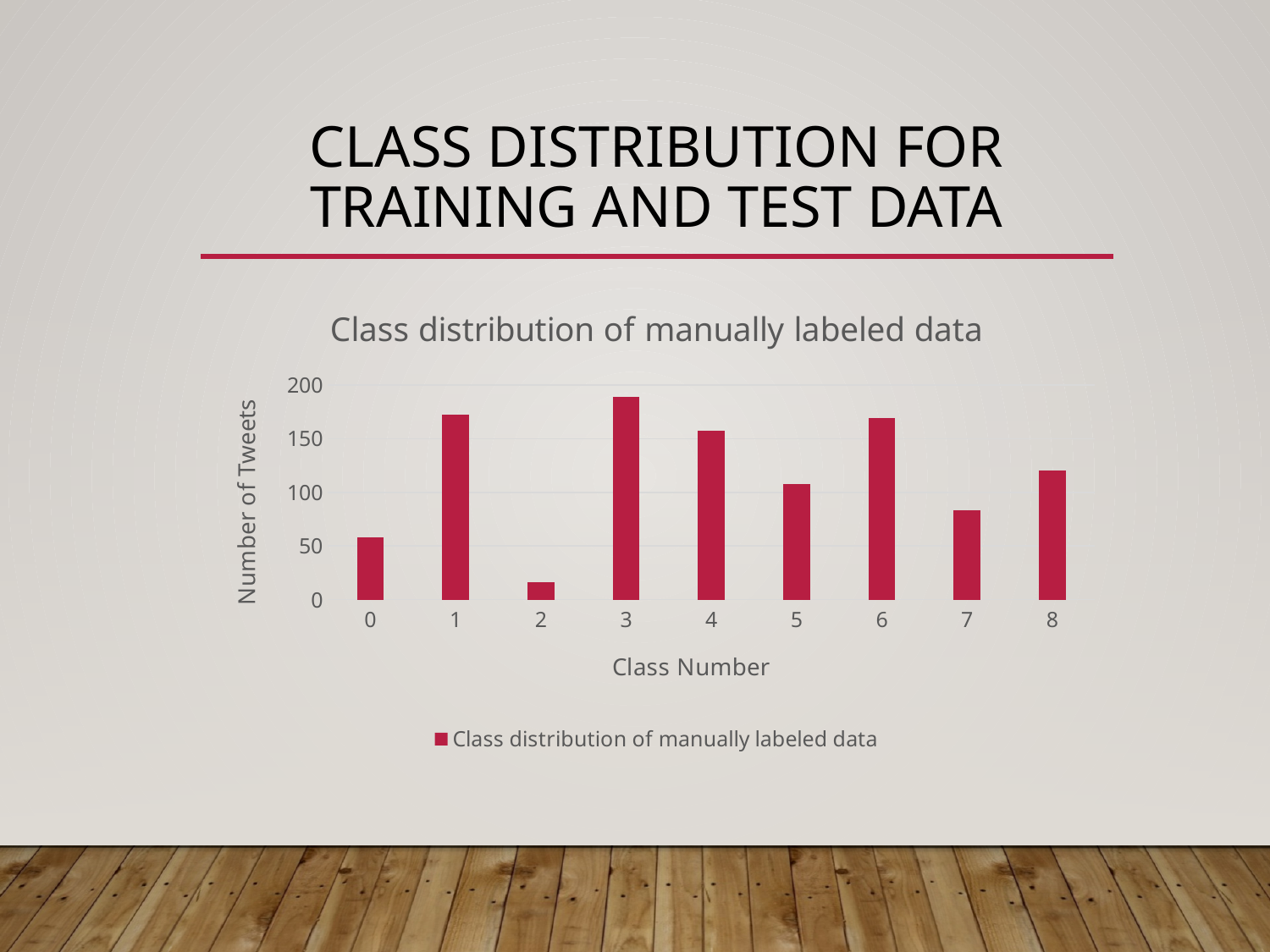
What kind of chart is shown on the slide? bar chart Which has more tweets, class 4 or class 8? class 4 How many series does the legend list? 1 How many class numbers are shown on the x axis of the chart? 9 Is the number of tweets for class 2 greater or less than 50? less What is the title of the chart? Class distribution of manually labeled data Which class number has the highest number of tweets? 3 Which has more tweets, class 0 or class 5? class 5 Is the number of tweets for class 3 greater or less than 150? greater Is the number of tweets for class 8 greater or less than 100? greater Which class number has the lowest number of tweets? 2